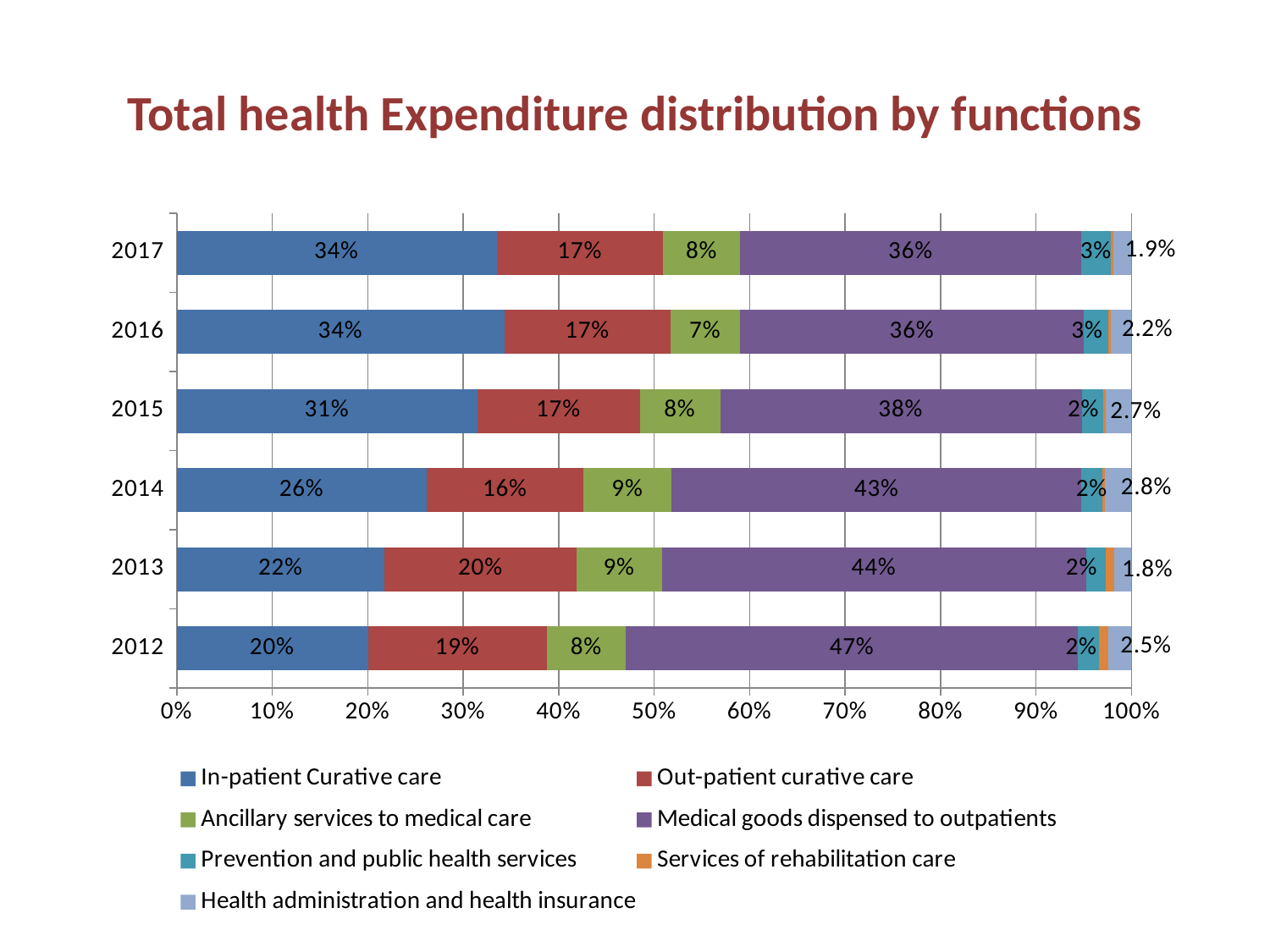
In which year is the value for In-patient Curative care the lowest? 2012 Which is larger: Out-patient curative care in 2013 or in 2017? 2013 What share of expenditure went to Medical goods dispensed to outpatients in 2012? 47% What is the value for Out-patient curative care in 2013? 20% What is the value for In-patient Curative care in 2017? 34% In which year is the value for Medical goods dispensed to outpatients the highest? 2012 What is the value for Health administration and health insurance in 2014? 2.8% How many years are shown on the chart? 6 What is the value for Prevention and public health services in 2016? 3% Does the share of In-patient Curative care rise or fall from 2012 to 2017? Rise By how many percentage points does Medical goods dispensed to outpatients in 2012 exceed the same category in 2017? 11 percentage points How many series does the legend list? 7